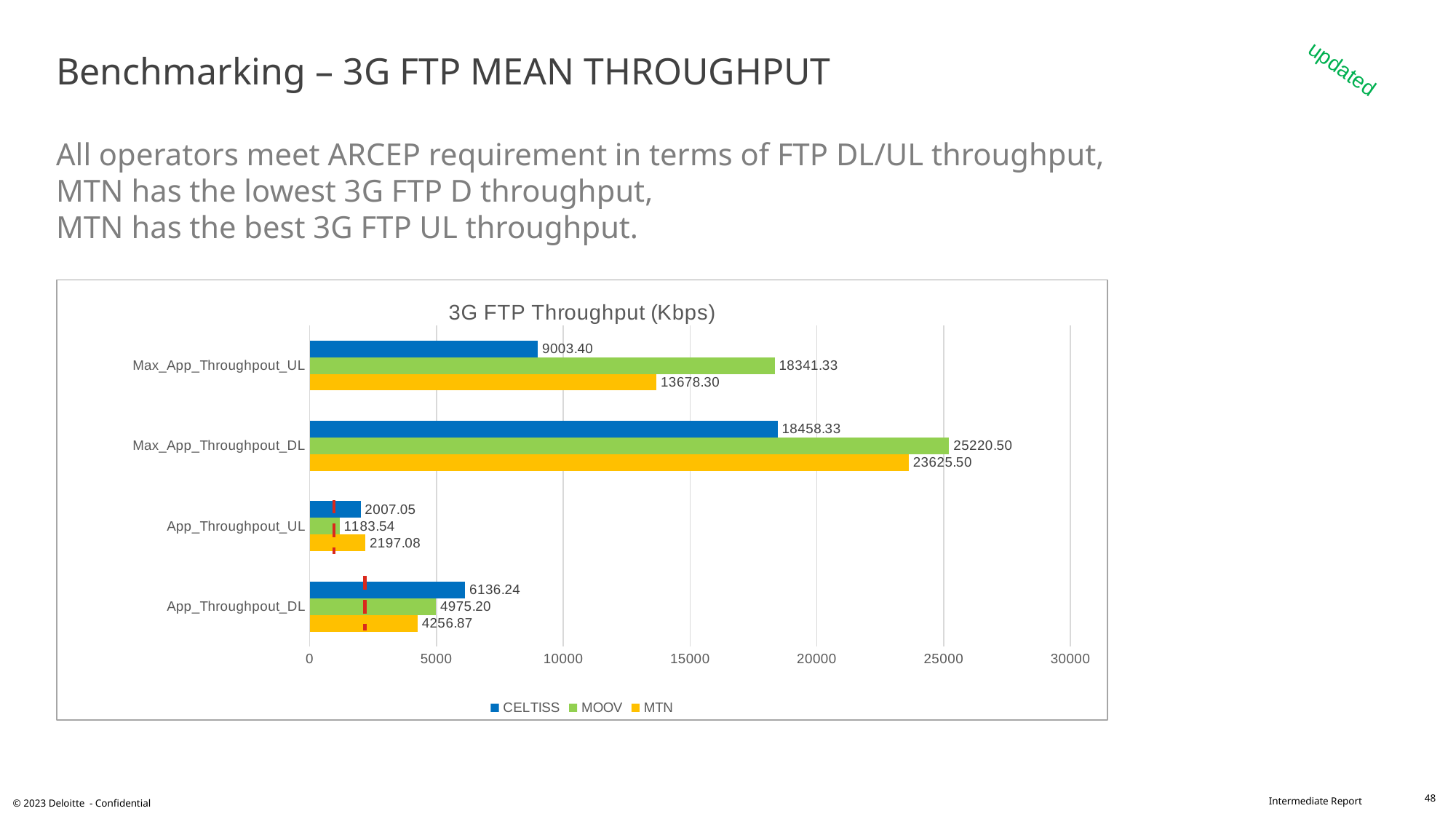
Which operator has the lowest value for App_Throughpout_UL? MOOV Which is larger for Max_App_Throughpout_UL, the MOOV value or the MTN value? MOOV What is the CELTISS value for Max_App_Throughpout_UL? 9003.40 What is the title of the chart? 3G FTP Throughput (Kbps) What kind of chart is shown on the slide? Bar chart What is the difference between the MOOV and CELTISS values for Max_App_Throughpout_DL? 6762.17 What is the MOOV value for Max_App_Throughpout_DL? 25220.50 Is the MTN value for Max_App_Throughpout_DL greater or less than 20000? greater What is the MTN value for App_Throughpout_UL? 2197.08 How many categories are shown on the chart? 4 Which operator has the highest value for App_Throughpout_DL? CELTISS How many series does the legend list? 3